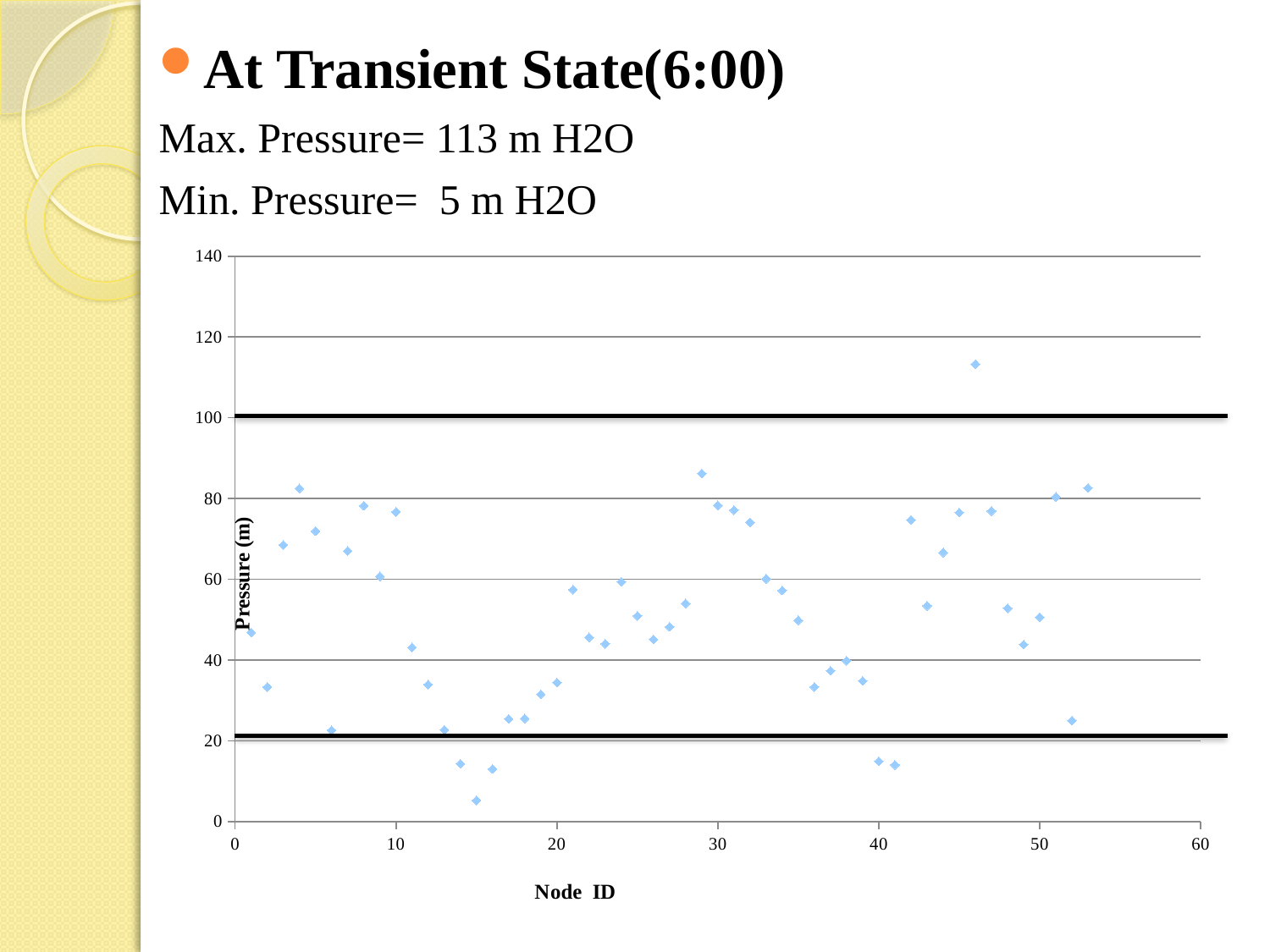
What kind of chart is shown on the slide? scatter chart Which has the higher pressure, the point at Node ID 46 or the point at Node ID 15? Node ID 46 Is the lowest plotted pressure value greater or less than 20? less Is the pressure plotted at Node ID 40 greater or less than 20? less Is any plotted pressure value greater than 120? No What is the label of the x axis of the chart? Node ID What is the label of the y axis of the chart? Pressure (m) What is the maximum pressure stated on the slide for the transient state? 113 m H2O What is the minimum pressure stated on the slide for the transient state? 5 m H2O